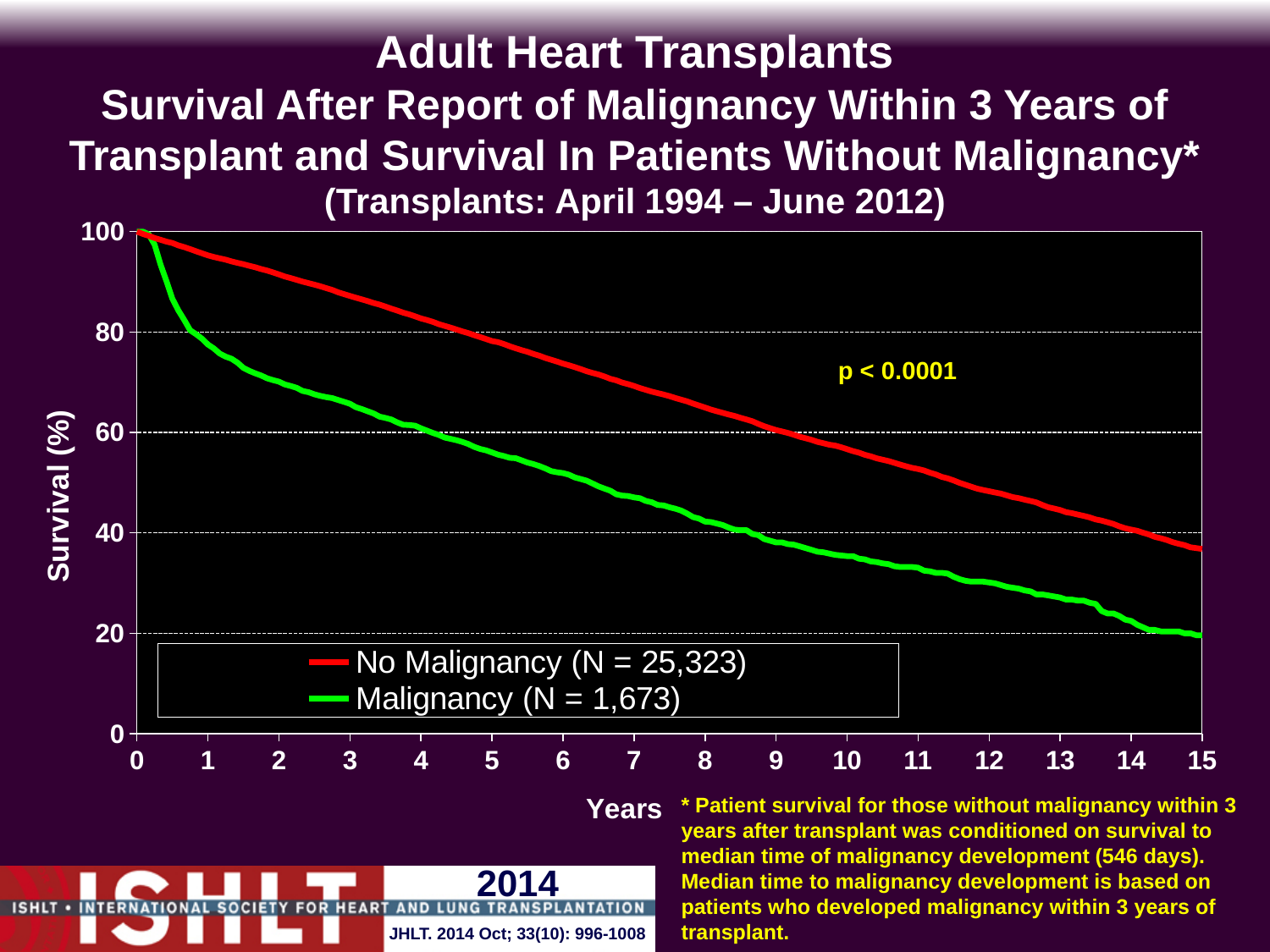
What p-value is printed on the chart? p < 0.0001 Is the survival value for the No Malignancy group at 5 years greater or less than 60? greater What is the number of patients (N) in the No Malignancy group according to the legend? 25,323 Is the survival value for the Malignancy group at 10 years greater or less than 40? less What is the maximum value shown on the x axis (Years)? 15 How many series does the legend list? 2 Which series has the higher survival at 5 years, No Malignancy or Malignancy? No Malignancy What kind of chart is shown on the slide? line chart Do the survival curves rise or fall as years increase? fall Is the survival value for the Malignancy group at 5 years greater or less than 60? less